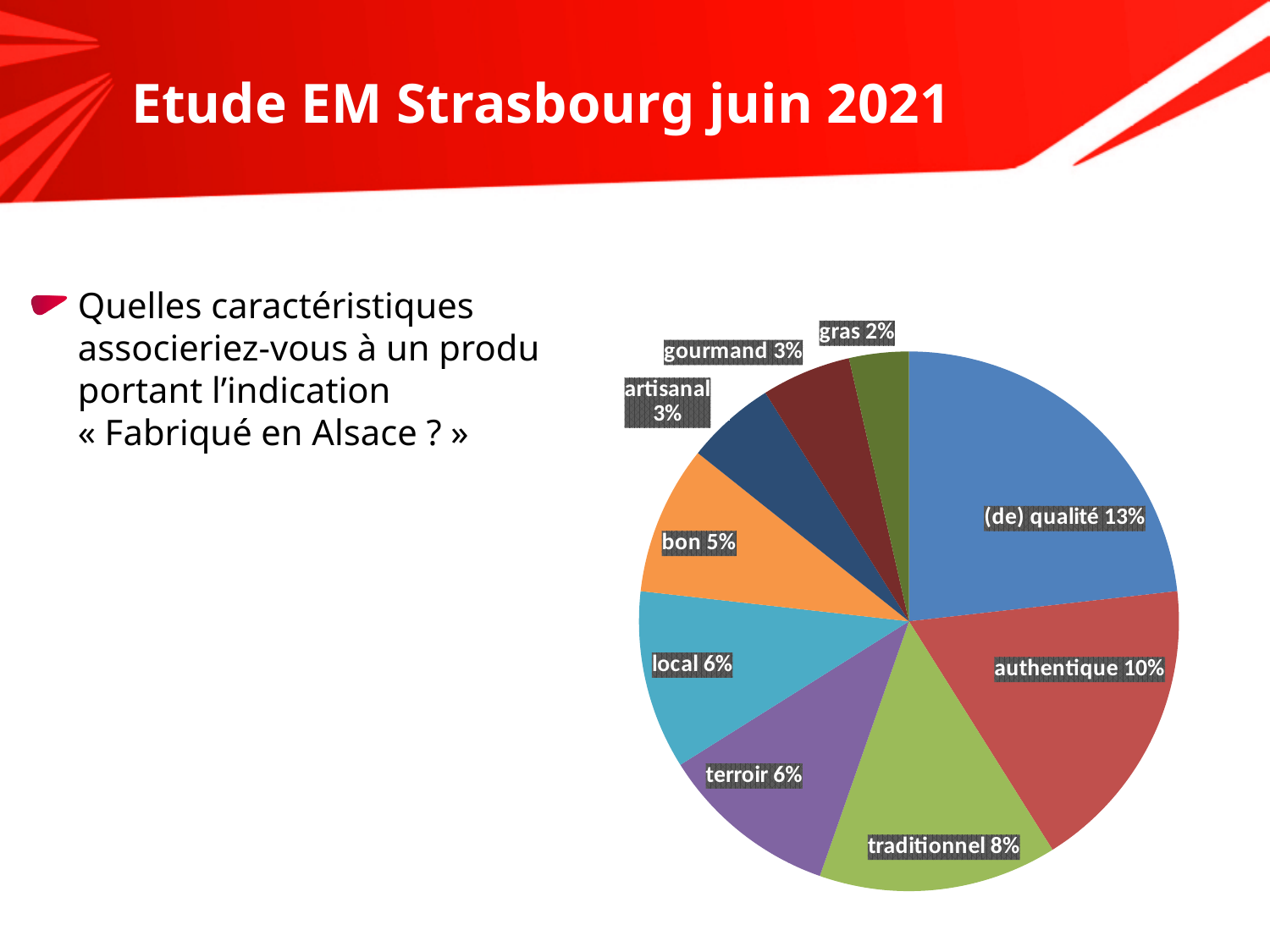
How many slices does the pie chart have? 9 What percentage is shown for the "traditionnel" slice? 8% What share of the pie is labelled for "gourmand"? 3% What percentage is shown for the "bon" slice? 5% Which characteristic has the largest slice of the pie? (de) qualité Which is larger, the "terroir" slice or the "bon" slice? terroir What is the difference in percentage points between "traditionnel" and "gras"? 6 What kind of chart is shown on the slide? pie chart What percentage is shown for the "(de) qualité" slice? 13% Which characteristic has the smallest slice of the pie? gras What is the difference in percentage points between "(de) qualité" and "authentique"? 3 What percentage is shown for the "authentique" slice? 10%